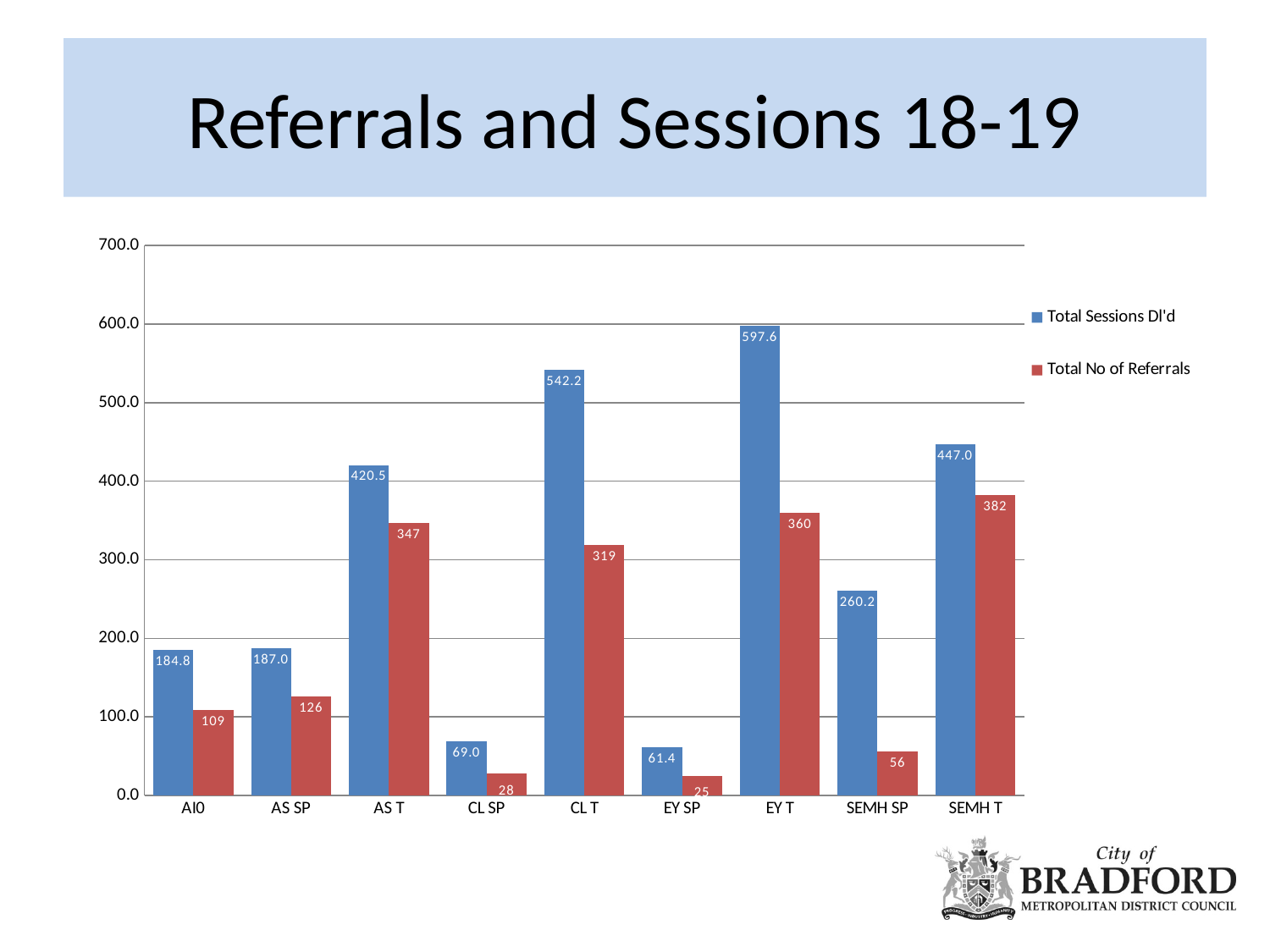
What is the Total Sessions Dl'd value for CL SP? 69.0 Which is larger: Total Sessions Dl'd for AS T or for SEMH T? SEMH T What colour are the Total No of Referrals bars? red Is the Total Sessions Dl'd value for SEMH SP greater or less than 300? less How many categories are shown on the x axis? 9 What is the difference between Total No of Referrals for AS T and CL T? 28 Which category has the lowest Total No of Referrals? EY SP What is the Total Sessions Dl'd value for EY T? 597.6 How many series does the legend list? 2 What kind of chart is shown on the slide? bar chart Which category has the highest Total Sessions Dl'd? EY T What is the Total No of Referrals for SEMH T? 382